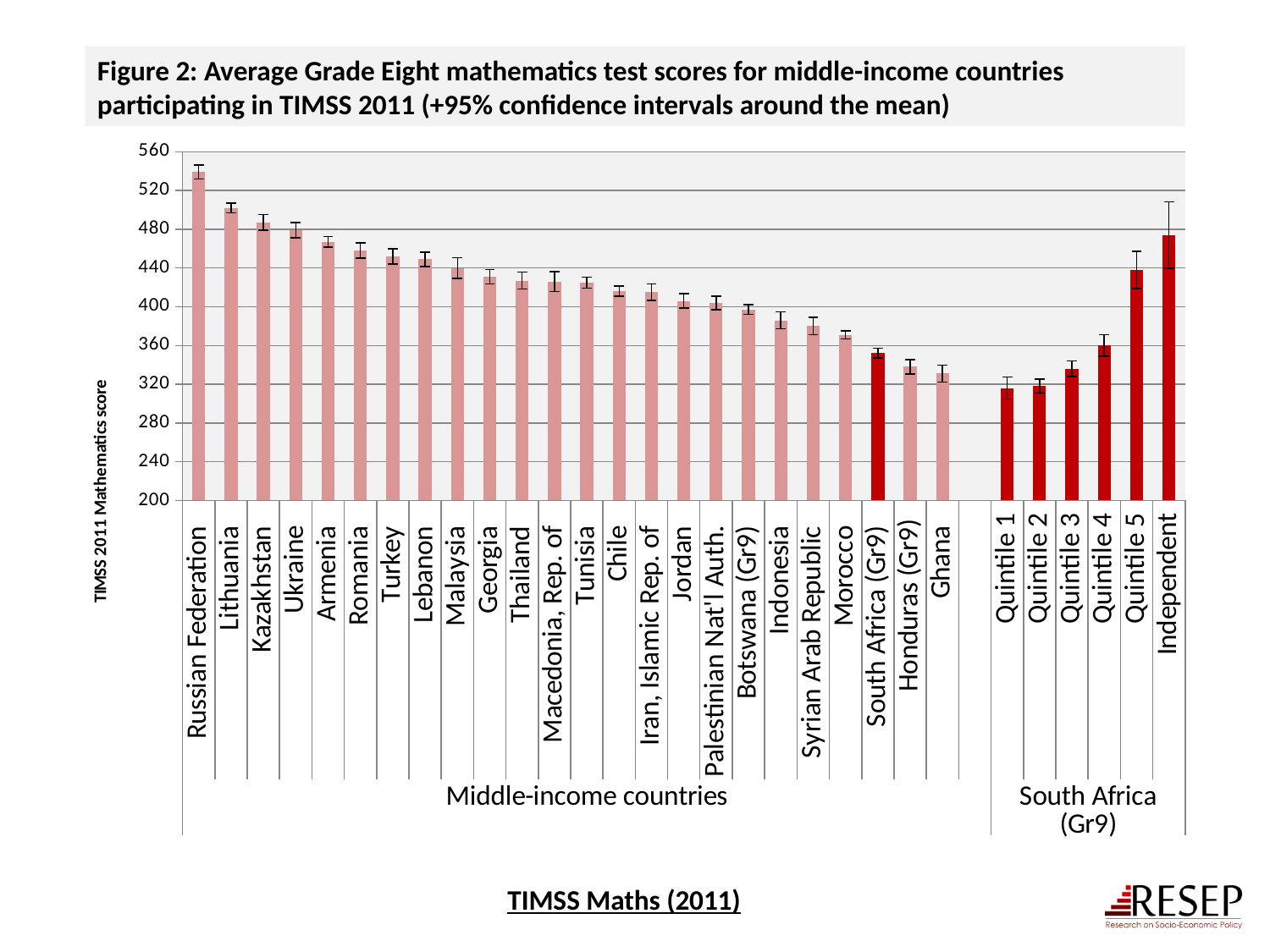
Is the value for Russian Federation greater or less than 520? greater How many bars are plotted in the chart in total? 30 Is the value for Independent greater or less than 440? greater Which category has the highest TIMSS 2011 mathematics score? Russian Federation Is the value for Ghana greater or less than 360? less Which has the larger score, Independent or Quintile 5? Independent What kind of chart is shown on the slide? Bar chart What is the title of the vertical axis? TIMSS 2011 Mathematics score Which has the larger score, Turkey or Thailand? Turkey Do the scores for the middle-income countries rise or fall from left to right along the x axis? Fall